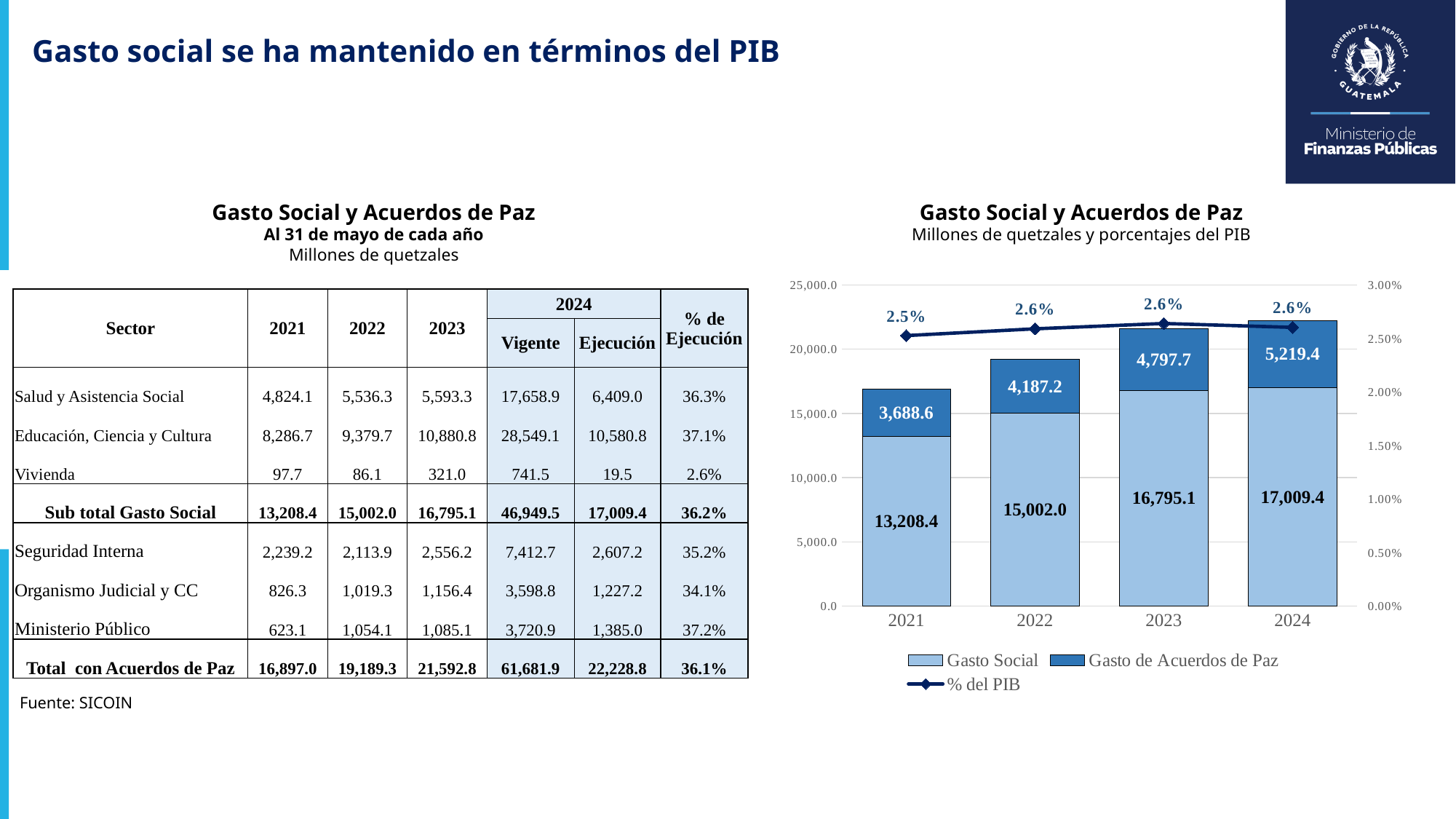
What is the difference between the Gasto Social values for 2024 and 2021? 3,801.0 How many series does the chart legend list? 3 What is the value of Gasto Social for 2022? 15,002.0 How many years are shown on the x axis of the chart? 4 What is the total of the stacked bar for 2023? 21,592.8 What type of chart is shown on the slide? Stacked bar chart with a line Is the Gasto de Acuerdos de Paz value larger in 2022 or in 2024? 2024 What is the % del PIB value for 2021? 2.5% Does the Gasto Social value rise or fall from 2021 to 2024? Rise Which year has the lowest Gasto de Acuerdos de Paz value? 2021 What is the value of Gasto de Acuerdos de Paz for 2023? 4,797.7 Which year has the highest Gasto Social value? 2024